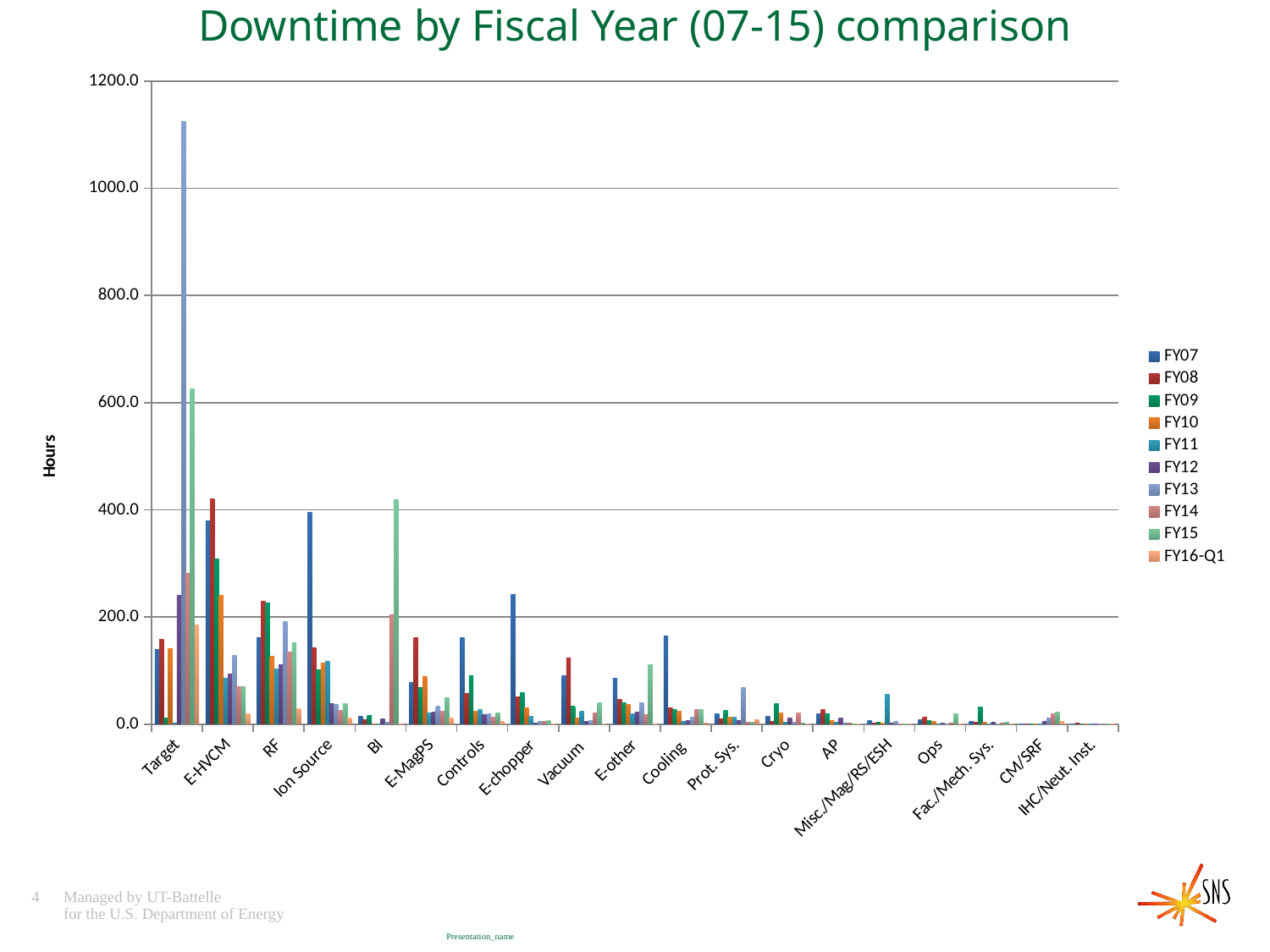
Which is larger for Target: the FY13 value or the FY15 value? FY13 What kind of chart is shown on the slide? bar chart How many series does the legend list? 10 Which fiscal year series has the tallest bar for the BI category? FY15 How many categories are shown along the x axis? 19 Is the FY13 value for Target greater or less than 1000? greater What is the title of the chart? Downtime by Fiscal Year (07-15) comparison Which fiscal year series has the tallest bar for the E-chopper category? FY07 Which fiscal year series has the tallest bar for the Target category? FY13 What is the label of the vertical axis? Hours Is the FY07 value for Cooling greater or less than 200? less Is the FY07 value for Ion Source greater or less than 200? greater